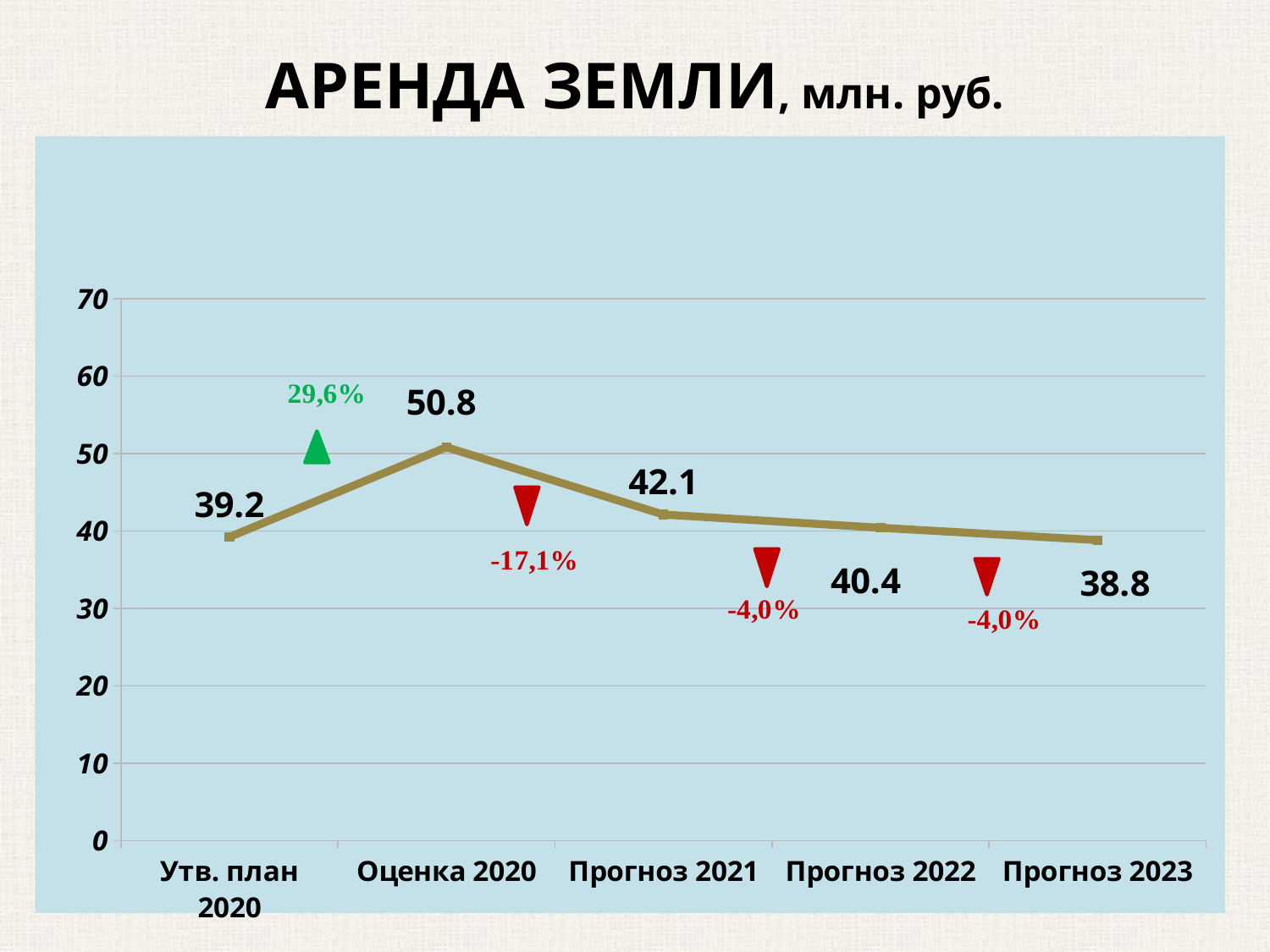
Which category has the highest value? Оценка 2020 What is the value for Прогноз 2023? 38.8 What is the value for Оценка 2020? 50.8 How many categories are shown on the x axis? 5 What is the value for Утв. план 2020? 39.2 What percentage change is shown between Оценка 2020 and Прогноз 2021? -17,1% Which category has the lowest value? Прогноз 2023 Which is larger, the value for Прогноз 2022 or the value for Прогноз 2023? Прогноз 2022 What is the difference between the values for Оценка 2020 and Прогноз 2021? 8.7 Do the values rise or fall from Оценка 2020 to Прогноз 2023? fall Is the value for Оценка 2020 greater or less than 50? greater What kind of chart is shown on the slide? line chart